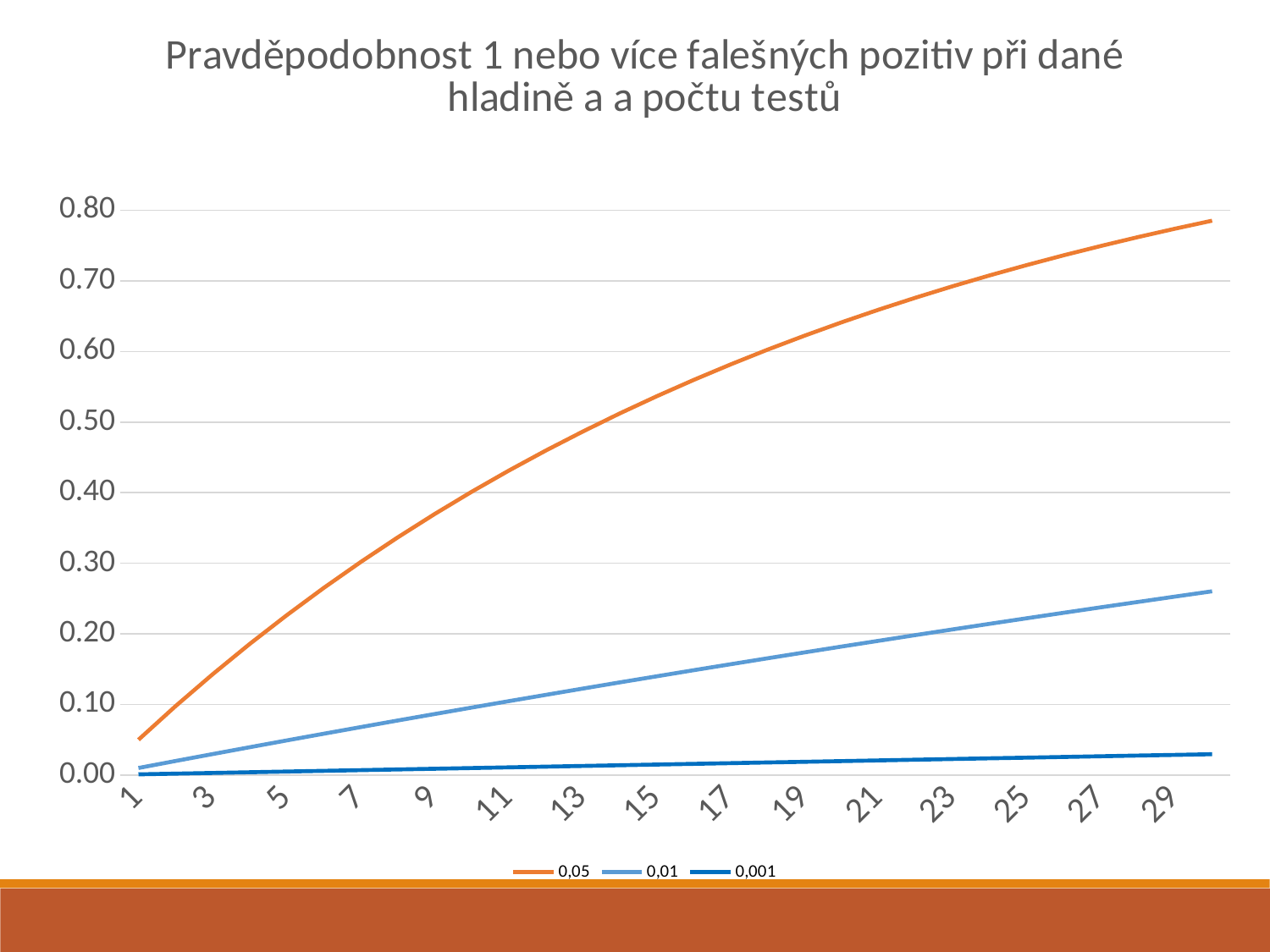
Do the values of the 0,05 series rise or fall as the number of tests increases along the x axis? rise Is the value for the 0,05 series at x = 9 greater or less than 0.30? greater Which series has the lowest value at x = 29? 0,001 What are the three series named in the legend? 0,05, 0,01, 0,001 Is the value for the 0,05 series at x = 29 greater or less than 0.70? greater What kind of chart is shown on the slide? line chart At x = 21, which series has the larger value, 0,01 or 0,001? 0,01 Is the value for the 0,001 series at x = 29 greater or less than 0.10? less How many series does the legend list? 3 Which series has the highest value at x = 29? 0,05 What is the title of the chart? Pravděpodobnost 1 nebo více falešných pozitiv při dané hladině a a počtu testů